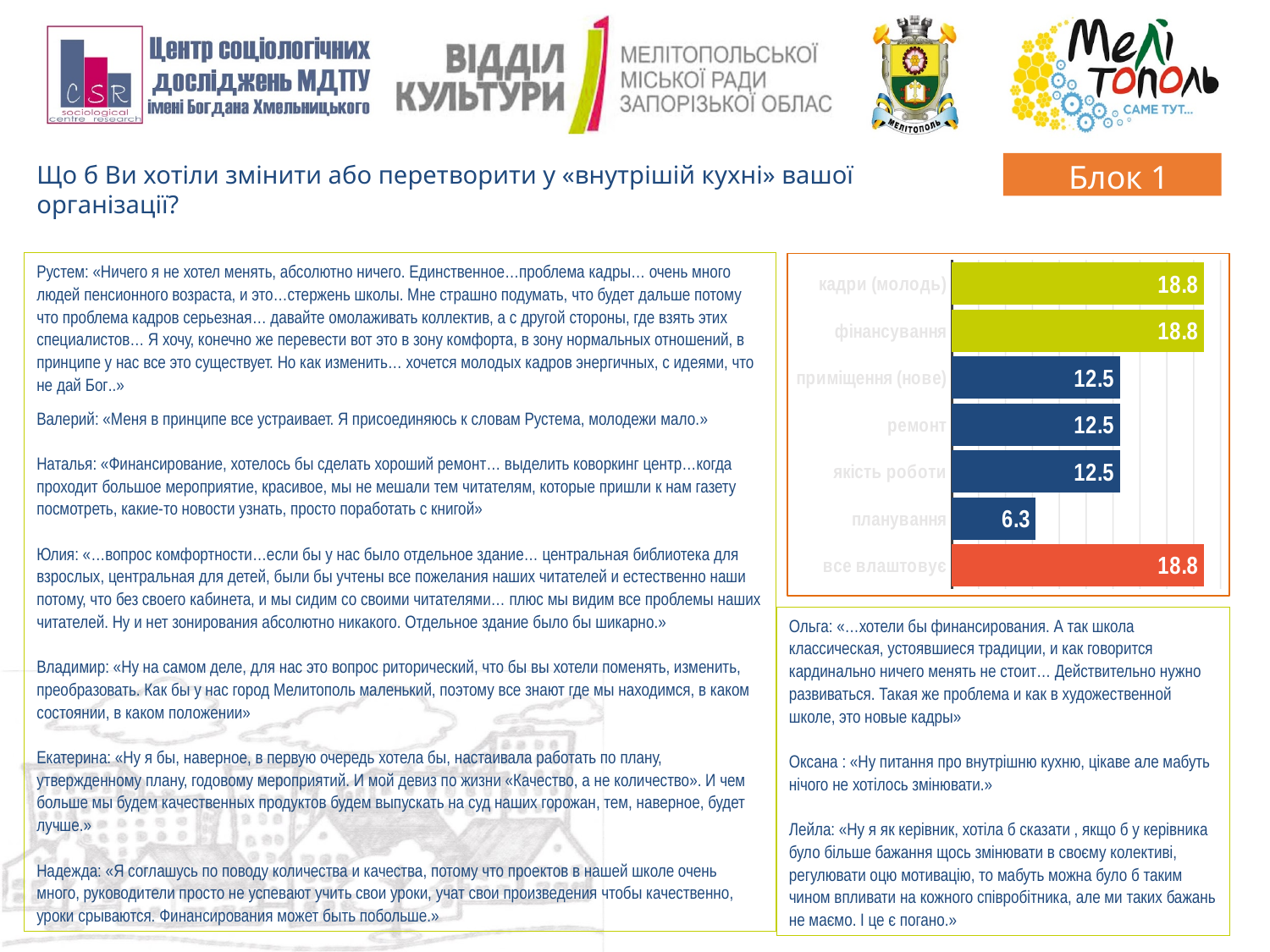
What is the value for «ремонт»? 12.5 What is the highest value shown in the chart? 18.8 Which category has the lowest value? планування Which is larger, the value for «приміщення (нове)» or the value for «планування»? приміщення (нове) How many categories are shown in the chart? 7 What colour is the bar for «все влаштовує»? orange What kind of chart is shown on the slide? bar chart What is the difference between the values for «кадри (молодь)» and «планування»? 12.5 What is the difference between the values for «фінансування» and «якість роботи»? 6.3 What is the value for «планування»? 6.3 What is the value for «фінансування»? 18.8 What is the value for «все влаштовує»? 18.8